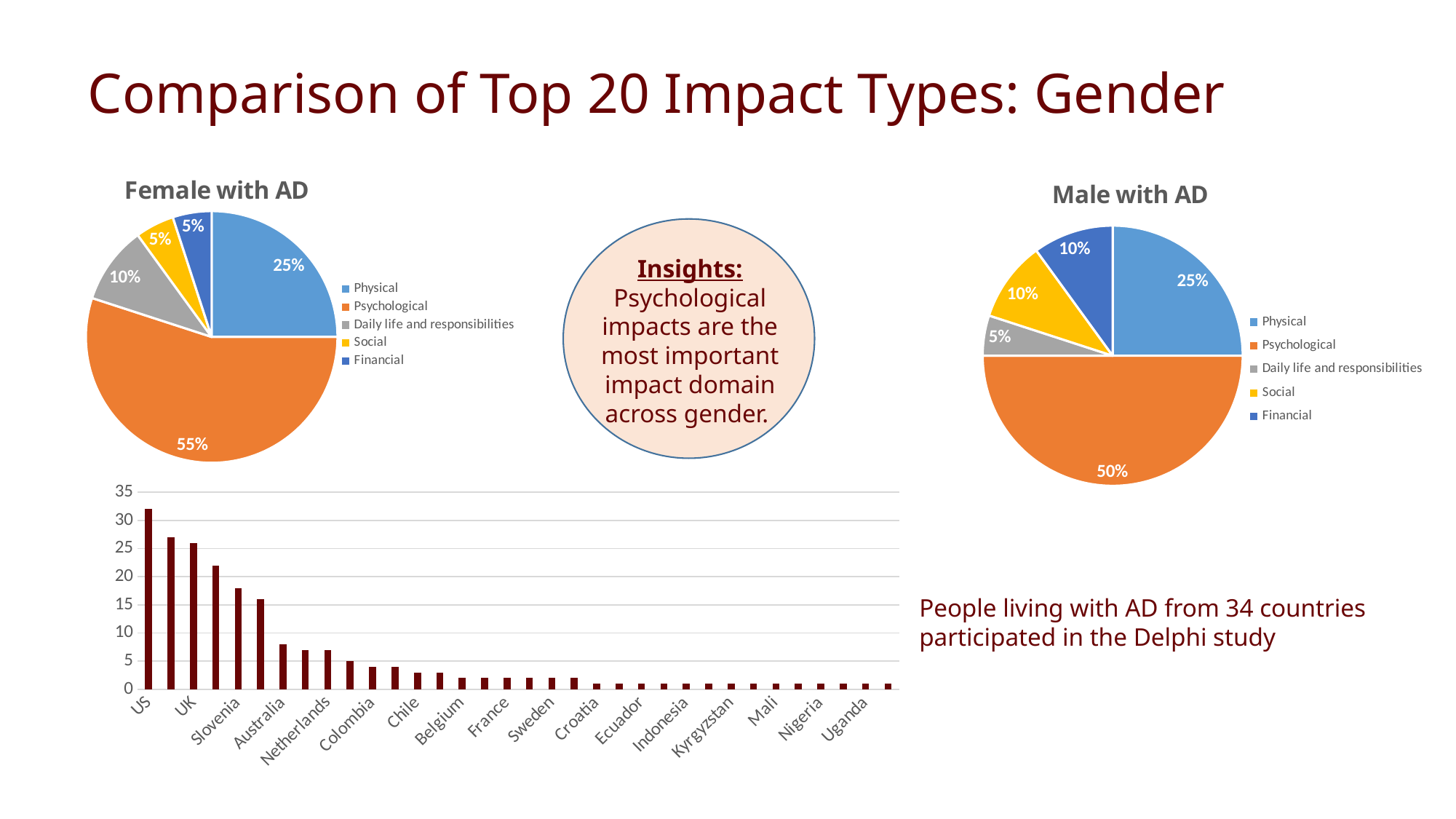
In the Male with AD pie chart, which category has the smallest share? Daily life and responsibilities In the bar chart at the bottom left, is the value for Netherlands greater or less than 10? less How many categories does the legend of the Female with AD pie chart list? 5 In the Male with AD pie chart, what percentage is Psychological? 50% In the Male with AD pie chart, what percentage is Daily life and responsibilities? 5% What type of chart is the Male with AD chart? Pie chart In the Female with AD pie chart, which category has the largest share? Psychological What is the difference between the Psychological share in the Female with AD pie chart and the Psychological share in the Male with AD pie chart? 5% Is the Financial share larger in the Female with AD pie chart or the Male with AD pie chart? Male with AD In the Female with AD pie chart, what percentage is Psychological? 55% In the bar chart at the bottom left, which country has the highest bar? US In the bar chart at the bottom left, is the value for US greater or less than 30? greater